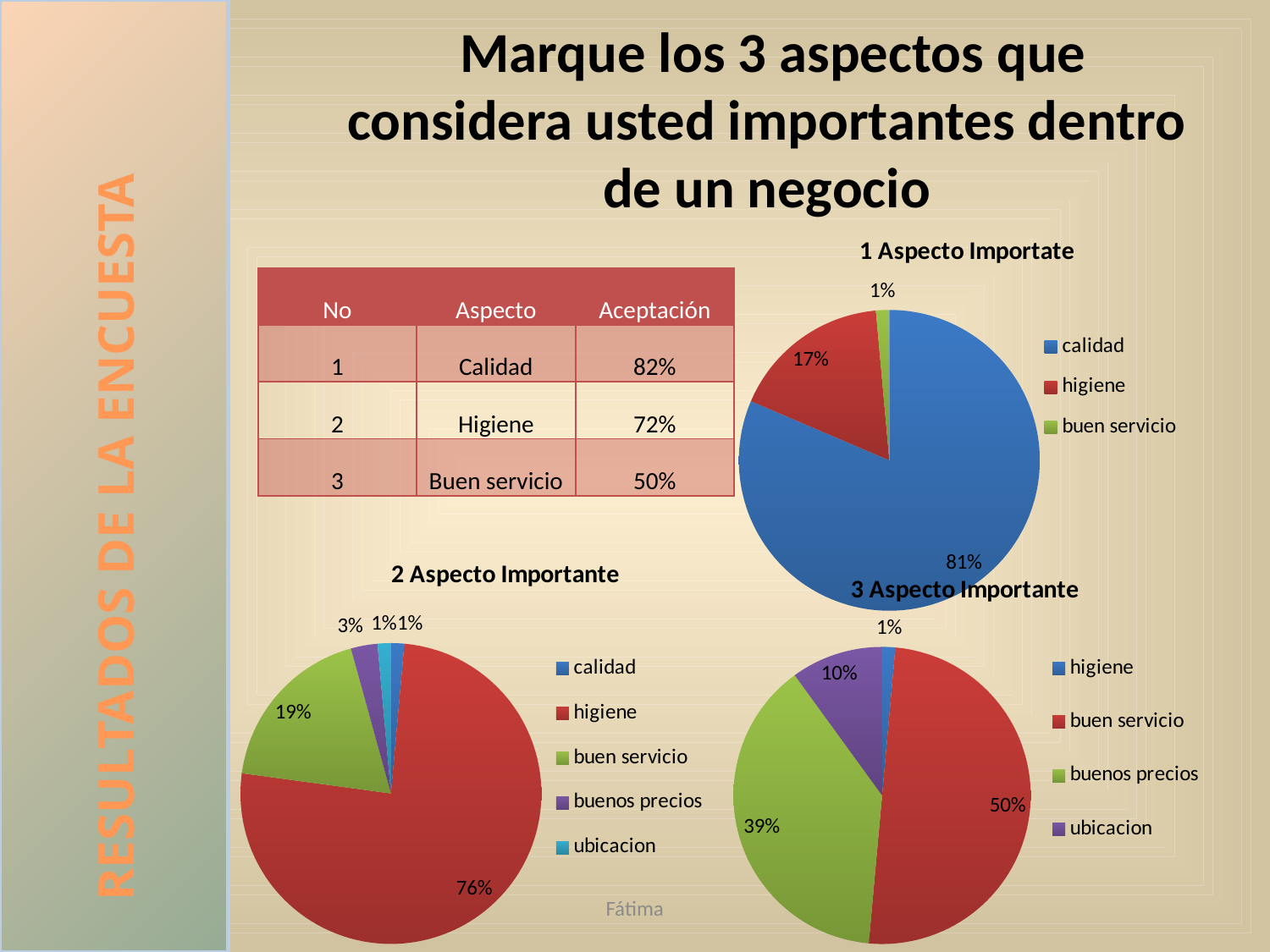
How many categories does the legend of the '2 Aspecto Importante' pie chart list? 5 In the pie chart titled '1 Aspecto Importate', which category has the largest slice? calidad In the pie chart titled '3 Aspecto Importante', which is larger, ubicacion or buenos precios? buenos precios In the pie chart titled '2 Aspecto Importante', what share does buen servicio have? 19% In the pie chart titled '3 Aspecto Importante', what share does buen servicio have? 50% In the pie chart titled '2 Aspecto Importante', what share does higiene have? 76% In the pie chart titled '1 Aspecto Importate', what share does higiene have? 17% What type of chart is '3 Aspecto Importante'? pie chart In the pie chart titled '3 Aspecto Importante', what share does buenos precios have? 39% How many entries does the legend of the '1 Aspecto Importate' pie chart list? 3 In the pie chart titled '2 Aspecto Importante', what is the difference between the higiene and buen servicio shares? 57% In the pie chart titled '1 Aspecto Importate', what share does calidad have? 81%